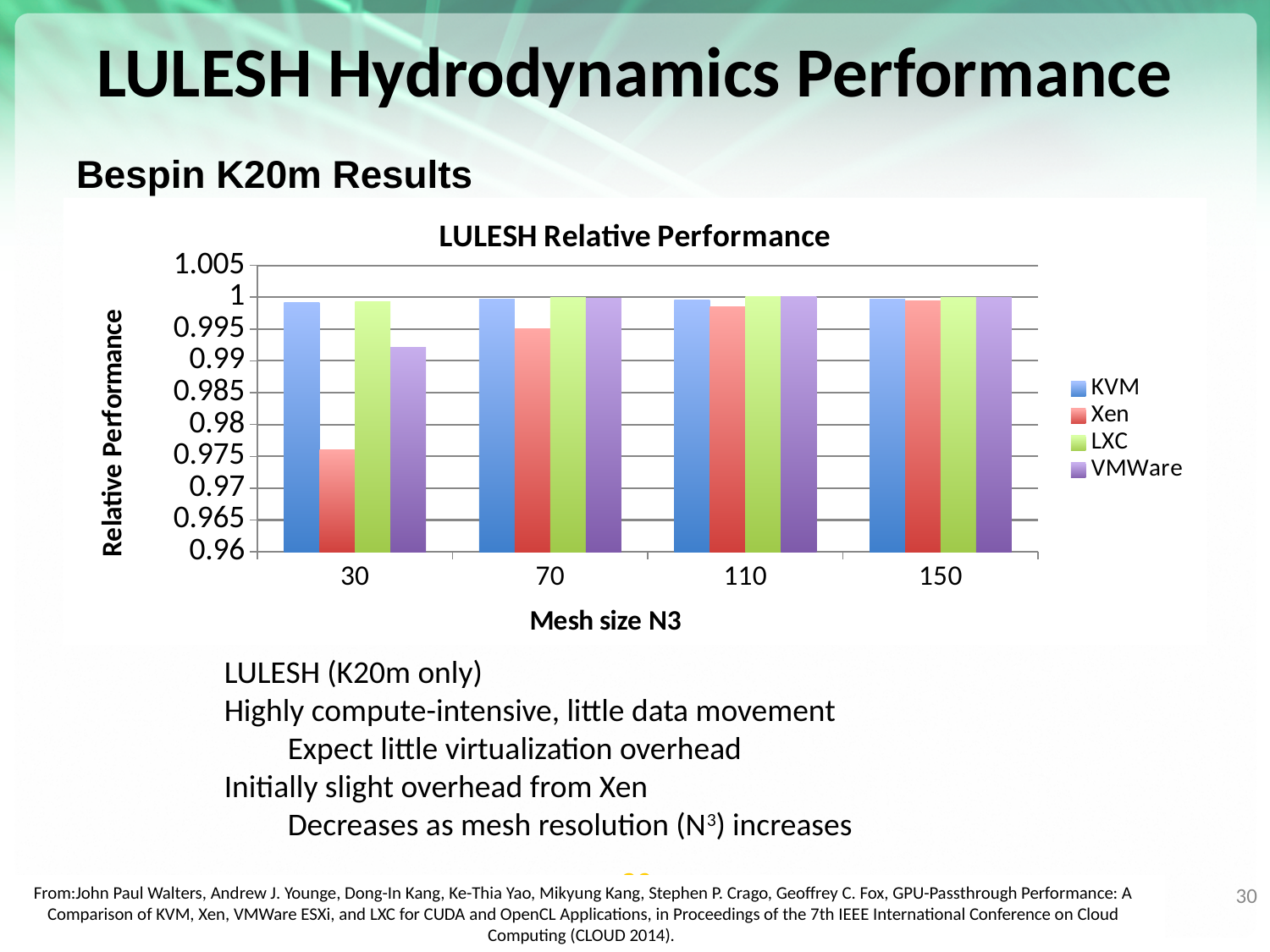
At mesh size 30, which is larger: the value for Xen or the value for VMWare? VMWare What is the label of the x axis of the chart? Mesh size N3 What is the title of the chart? LULESH Relative Performance Is the value for VMWare at mesh size 30 greater or less than 0.99? greater Is the value for Xen at mesh size 70 greater or less than 0.99? greater How many mesh size categories are shown on the x axis of the chart? 4 Does the relative performance of Xen rise or fall as mesh size increases from 30 to 150? rise What kind of chart is shown on the slide? bar chart Which series has the lowest relative performance at mesh size 30? Xen Is the value for Xen at mesh size 30 greater or less than 0.98? less How many series does the chart legend list? 4